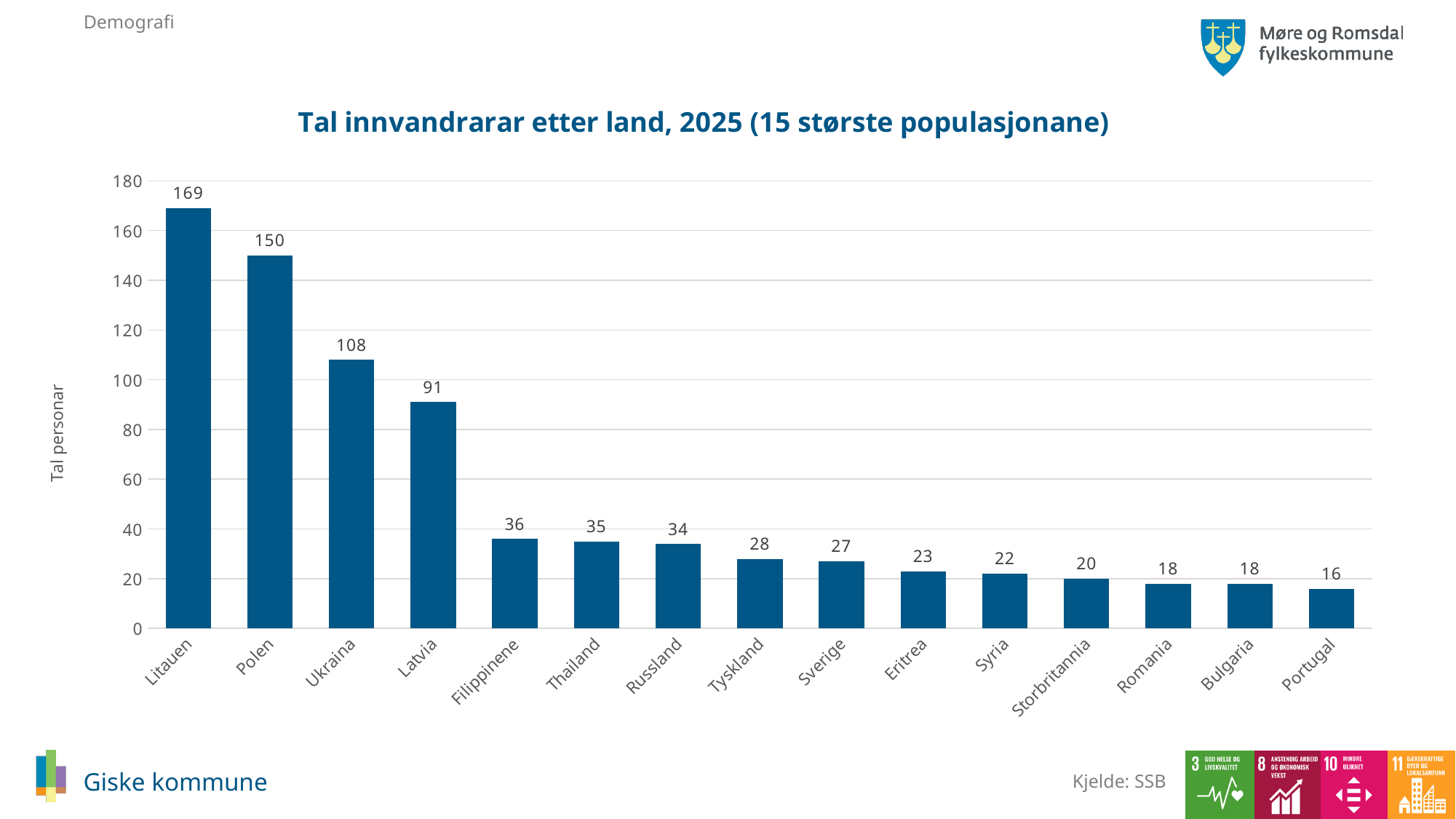
What is the value for Eritrea? 23 What is the difference between the values for Latvia and Filippinene? 55 What is the value for Ukraina? 108 Which country has the highest value? Litauen Which is larger, the value for Thailand or the value for Tyskland? Thailand Is the value for Ukraina greater or less than 100? greater Which country has the lowest value? Portugal What is the difference between the values for Litauen and Polen? 19 What kind of chart is shown on the slide? bar chart What is the value for Litauen? 169 How many countries are shown in the chart? 15 What is the title of the chart? Tal innvandrarar etter land, 2025 (15 største populasjonane)